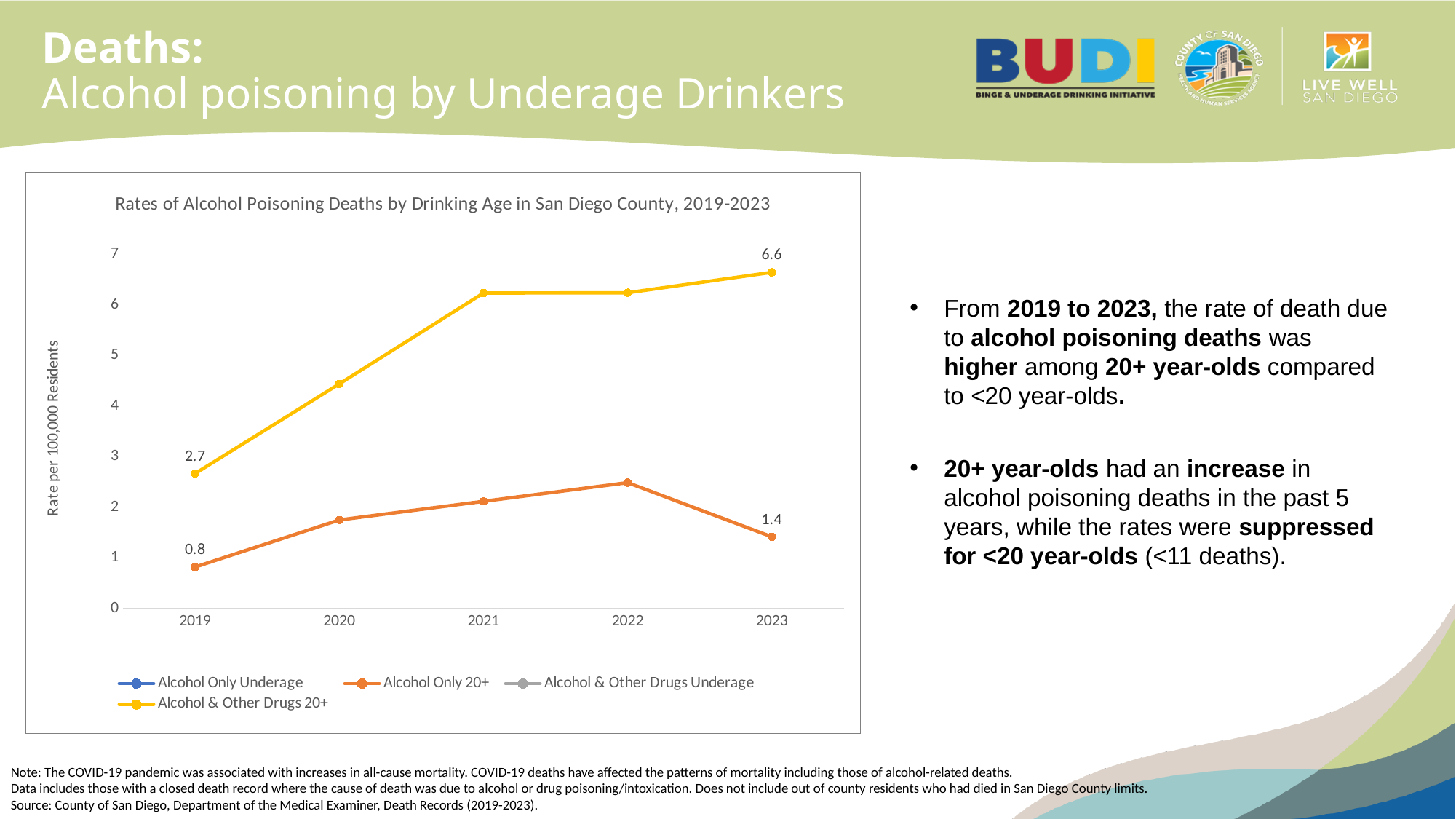
What is the difference between the Alcohol Only 20+ rate in 2023 and in 2019? 0.6 By how much did the Alcohol & Other Drugs 20+ rate change from 2019 to 2023? 3.9 What is the rate for Alcohol Only 20+ in 2019? 0.8 What is the rate for Alcohol & Other Drugs 20+ in 2019? 2.7 What kind of chart is shown on the slide? line chart What is the rate for Alcohol & Other Drugs 20+ in 2023? 6.6 Does the Alcohol & Other Drugs 20+ rate rise or fall from 2019 to 2023? rise Is the value for Alcohol Only 20+ in 2022 greater or less than 2? greater How many years are shown on the x axis? 5 In 2023, which series has the higher rate: Alcohol Only 20+ or Alcohol & Other Drugs 20+? Alcohol & Other Drugs 20+ How many series does the legend list? 4 What is the rate for Alcohol Only 20+ in 2023? 1.4